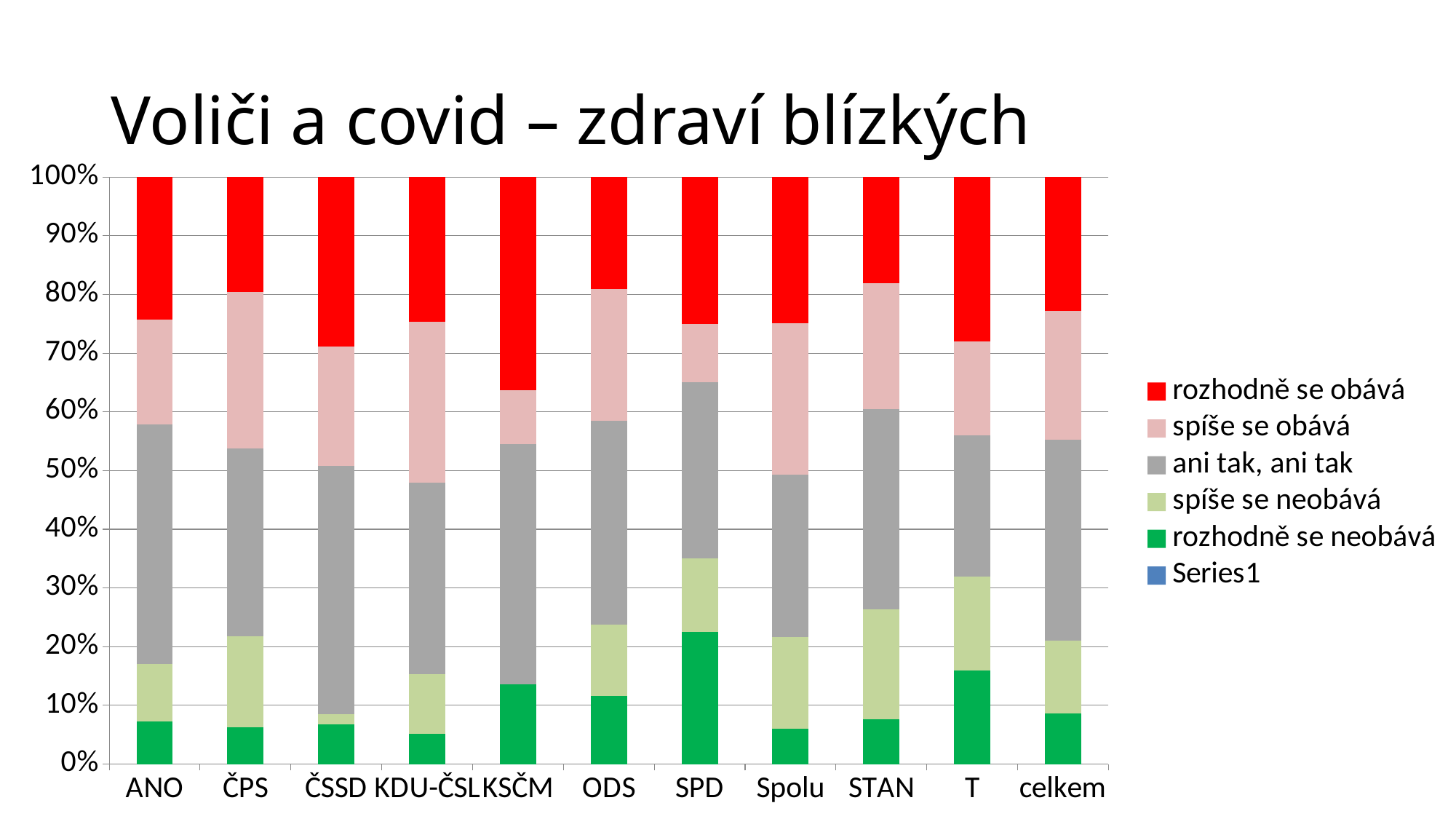
How many series does the legend list? 6 What is the title of the chart? Voliči a covid – zdraví blízkých Which category has the largest 'rozhodně se obává' segment? KSČM Which category has the largest 'rozhodně se neobává' segment? SPD Which has the larger 'rozhodně se obává' segment, KSČM or ODS? KSČM How many categories are shown along the x axis? 11 What kind of chart is shown on the slide? stacked bar chart Is the 'rozhodně se neobává' value for T greater or less than 10%? greater Which has the larger 'rozhodně se neobává' segment, SPD or ANO? SPD What colour represents 'rozhodně se obává' in the chart? red Is the 'rozhodně se neobává' value for ČSSD greater or less than 10%? less Is the 'rozhodně se neobává' value for SPD greater or less than 20%? greater